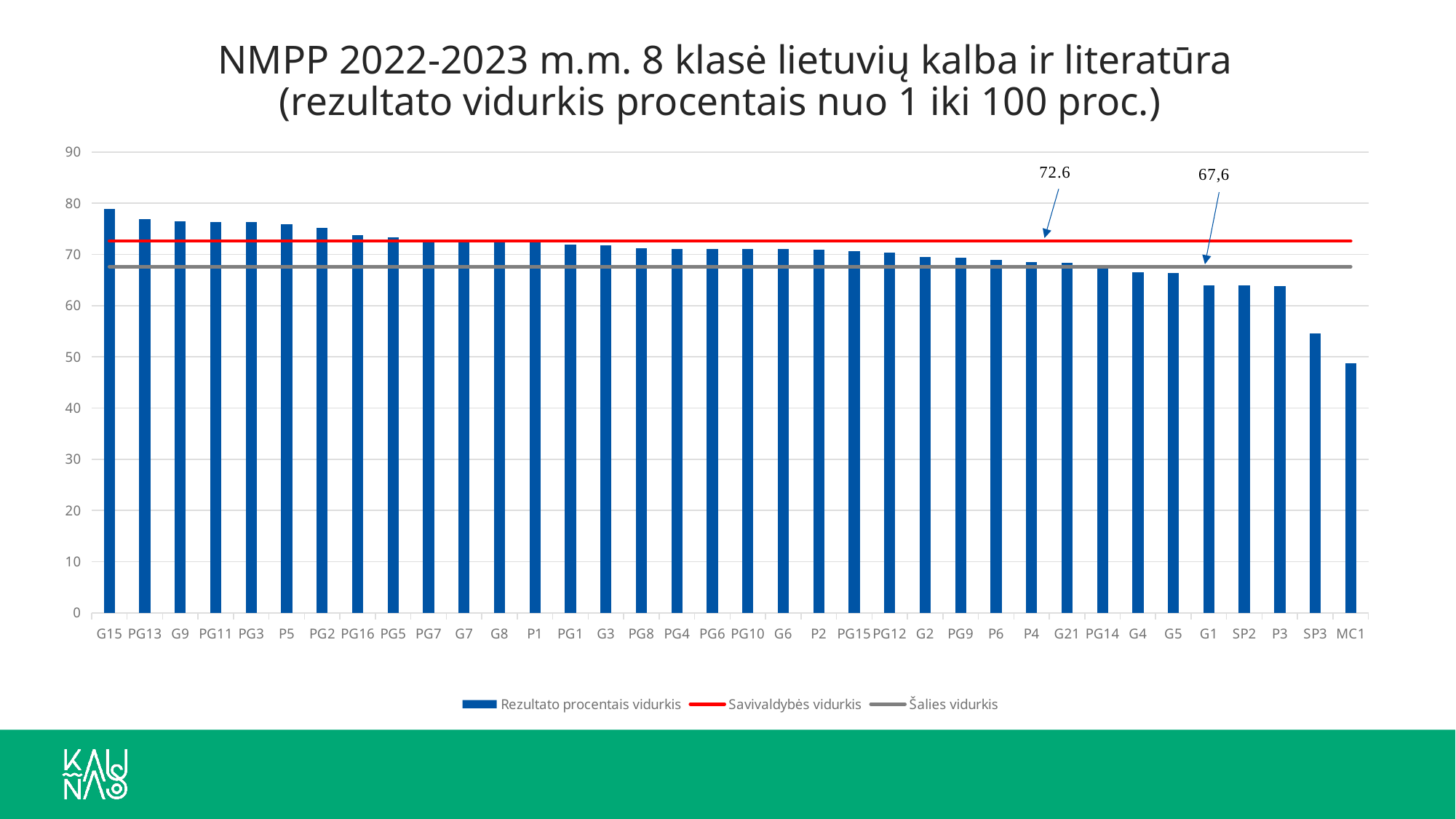
Is the value for G15 greater or less than 70? greater How many categories are shown on the x axis? 36 What value is labelled for the Savivaldybės vidurkis line? 72.6 Which category has the lowest bar? MC1 Which category has the highest bar? G15 What value is labelled for the Šalies vidurkis line? 67,6 Is the value for MC1 greater or less than 50? less Is the value for SP3 greater or less than 60? less Do the bar values rise or fall from left to right along the x axis? fall Which is larger, the bar for G15 or the bar for P3? G15 How many series does the legend list? 3 What kind of chart is shown on the slide? combination bar and line chart